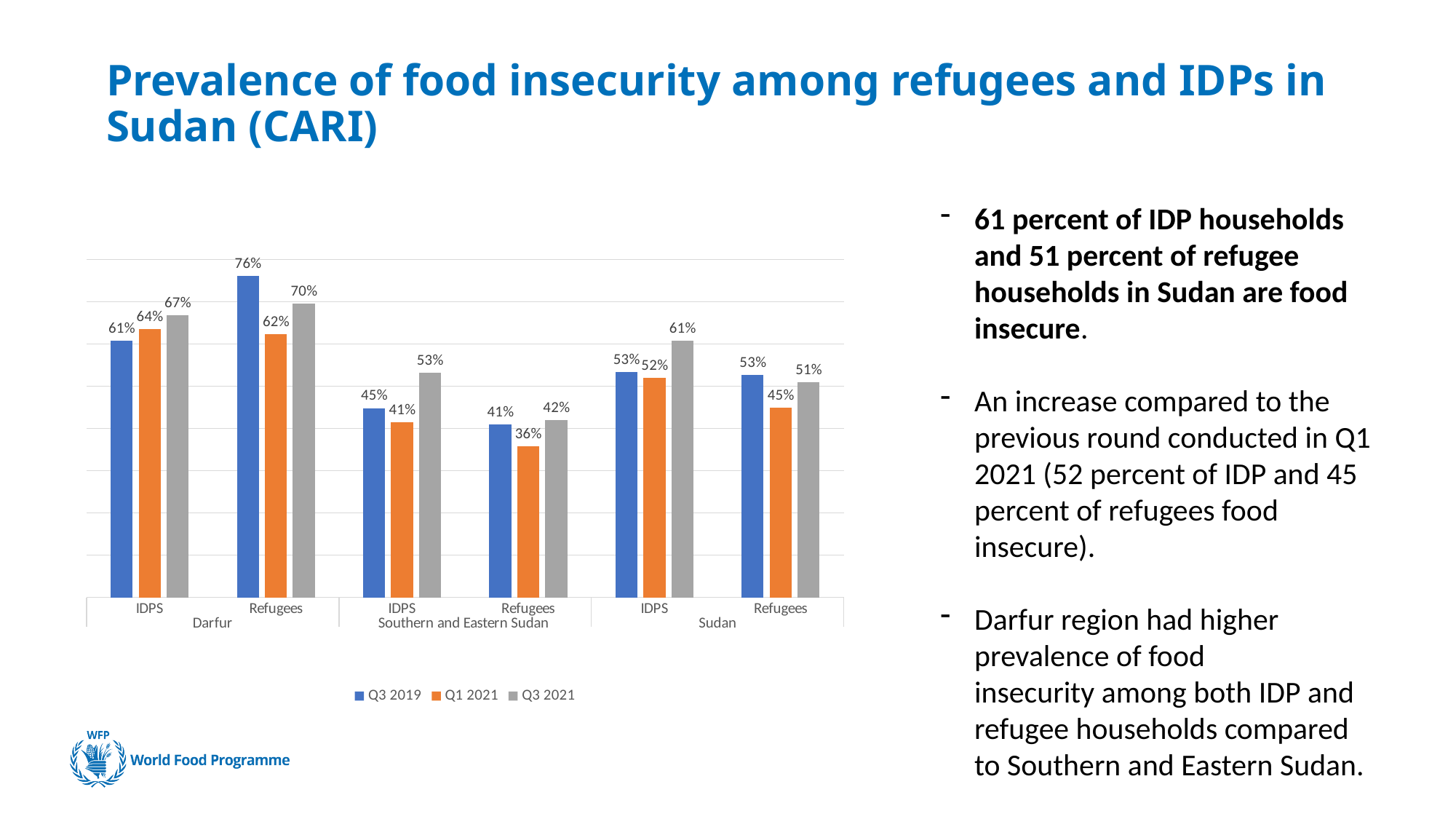
What is the Q3 2021 value for IDPS in Darfur? 67% What is the Q3 2019 value for Refugees in Darfur? 76% Which group has the highest Q3 2019 value? Refugees in Darfur Which group has the lowest Q1 2021 value? Refugees in Southern and Eastern Sudan How many groups of bars are shown on the x axis? 6 What is the Q1 2021 value for Refugees in Southern and Eastern Sudan? 36% Which is larger for Refugees in Sudan: the Q3 2019 value or the Q3 2021 value? Q3 2019 What kind of chart is shown on the slide? Bar chart What is the difference between the Q3 2021 and Q1 2021 values for IDPS in Southern and Eastern Sudan? 12% How many series does the legend list? 3 Which colour represents the Q1 2021 series in the legend? Orange What is the Q3 2021 value for IDPS in Sudan? 61%